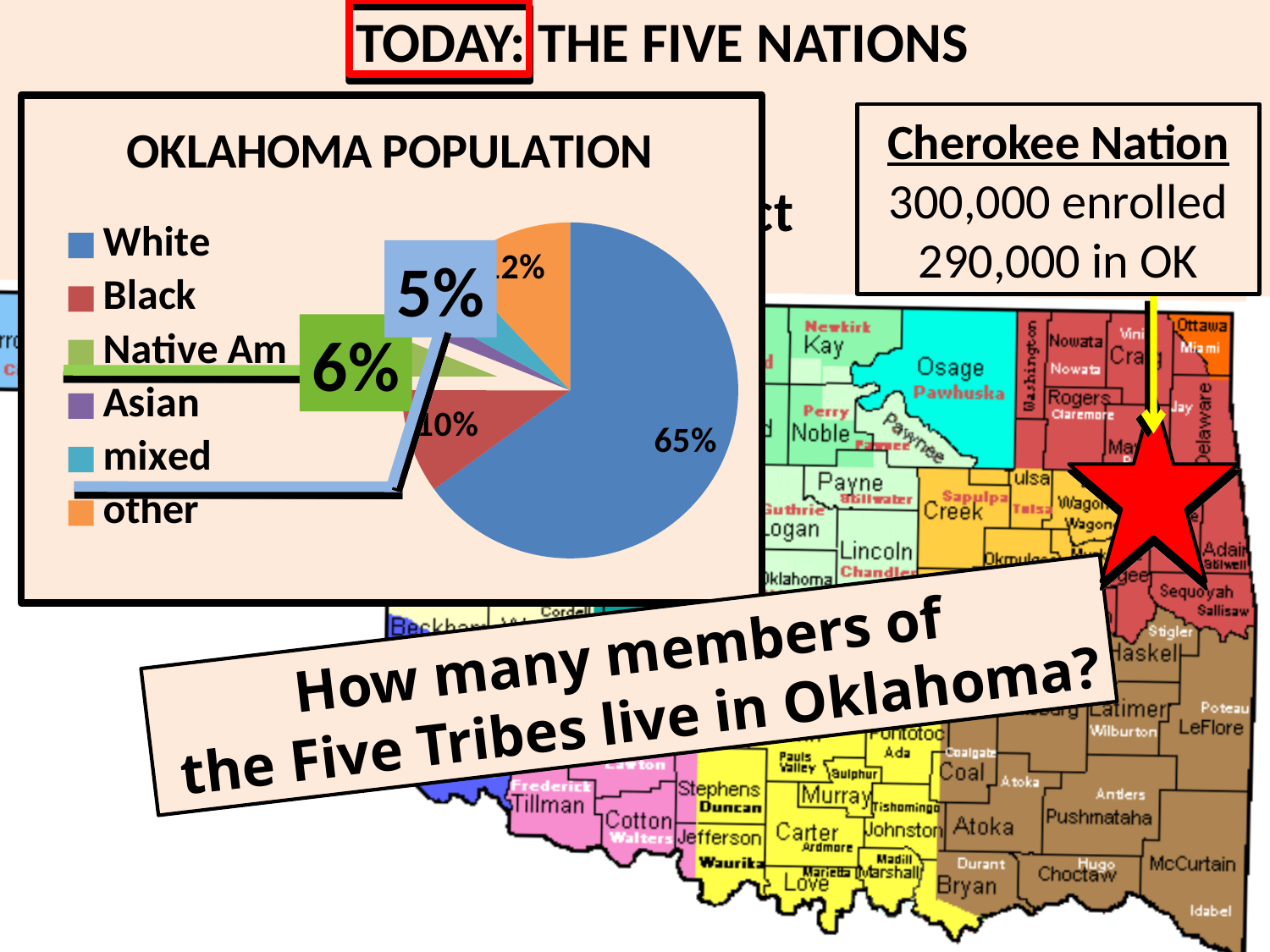
In the OKLAHOMA POPULATION pie chart, what is the difference between the White and Black percentages? 55% In the OKLAHOMA POPULATION pie chart, what percentage is shown for Black? 10% Which category has the smallest slice in the OKLAHOMA POPULATION pie chart? Asian In the OKLAHOMA POPULATION pie chart, what percentage is shown for mixed? 5% Which category has the largest slice in the OKLAHOMA POPULATION pie chart? White In the OKLAHOMA POPULATION pie chart, what percentage is shown for White? 65% In the OKLAHOMA POPULATION pie chart, what is the difference between the Native Am and mixed percentages? 1% In the OKLAHOMA POPULATION pie chart, what percentage is shown for Native Am? 6% What kind of chart is the OKLAHOMA POPULATION chart? pie chart How many categories does the legend of the OKLAHOMA POPULATION pie chart list? 6 What is the title of the pie chart on the slide? OKLAHOMA POPULATION In the OKLAHOMA POPULATION pie chart, which is larger, the White slice or the Black slice? White